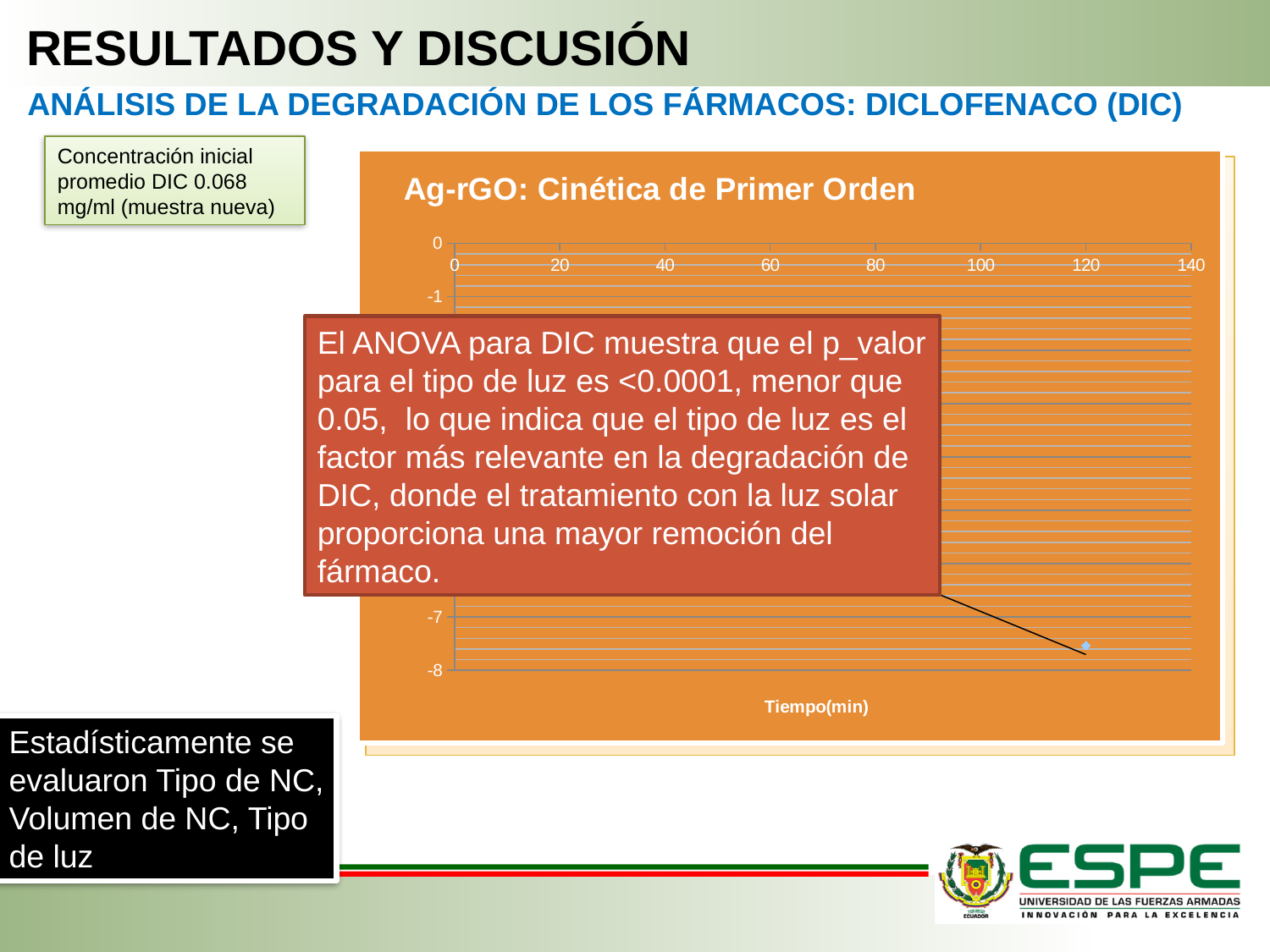
What is the lowest value shown on the y axis of the chart? -8 What is the label of the x axis of the chart? Tiempo(min) What kind of chart is shown on the slide? scatter chart What is the title of the chart on the slide? Ag-rGO: Cinética de Primer Orden What is the highest value shown on the x axis of the chart? 140 Is the y value of the data point plotted at 120 min greater or less than -7? less